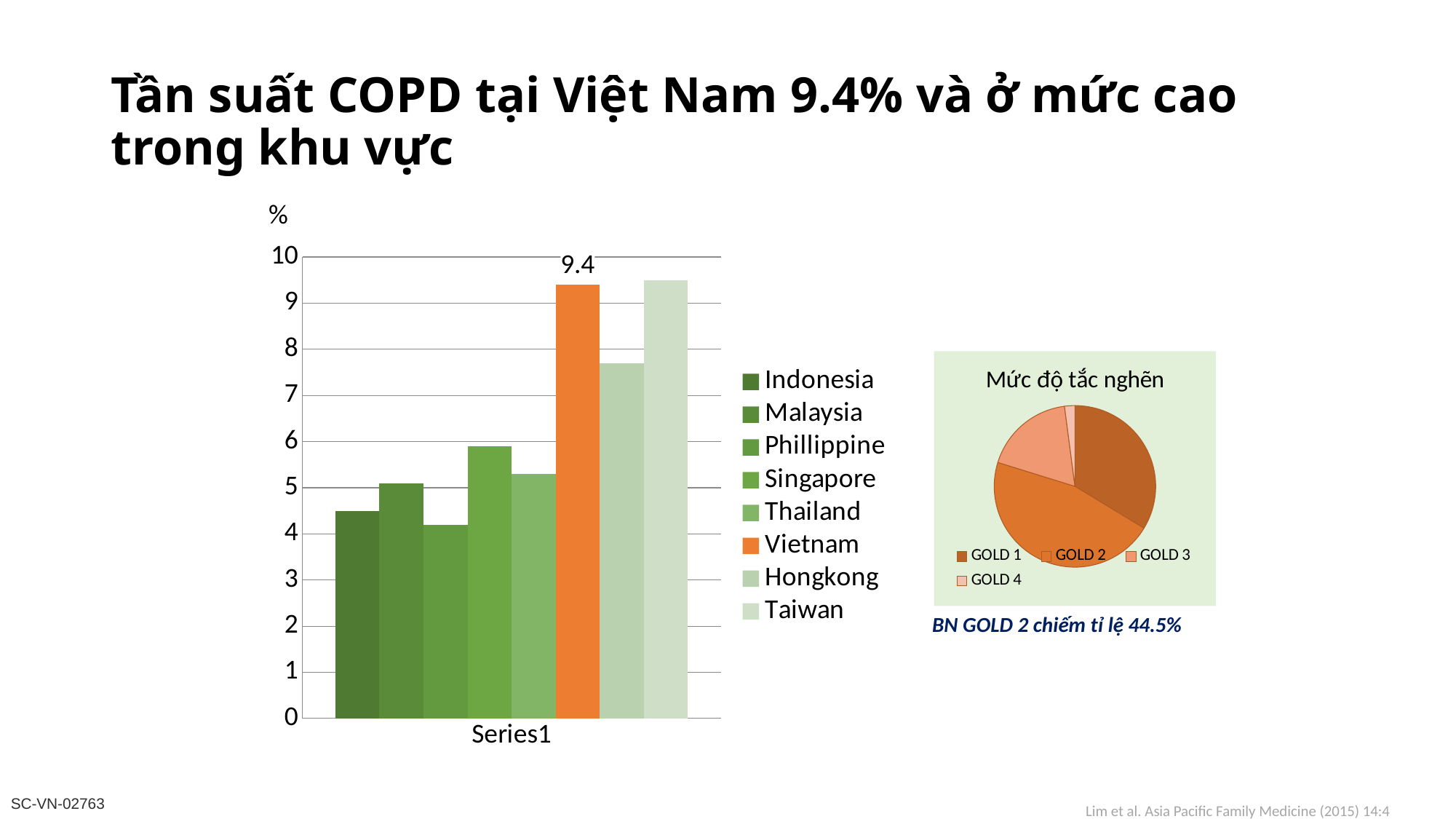
In the bar chart on the left, is the value for Hongkong greater or less than 7? greater In the pie chart titled "Mức độ tắc nghẽn", which slice is the smallest? GOLD 4 In the bar chart on the left, is the value for Phillippine greater or less than 5? less In the pie chart titled "Mức độ tắc nghẽn", what share does GOLD 2 account for? 44.5% How many entries does the legend of the bar chart on the left list? 8 How many entries does the legend of the pie chart titled "Mức độ tắc nghẽn" list? 4 In the bar chart on the left, which is larger, the value for Singapore or the value for Indonesia? Singapore In the bar chart on the left, which is larger, the value for Vietnam or the value for Hongkong? Vietnam What kind of chart is the chart on the left of the slide? bar chart What kind of chart is the chart titled "Mức độ tắc nghẽn"? pie chart In the bar chart on the left, what is the value for Vietnam? 9.4 In the bar chart on the left, is the value for Singapore greater or less than 5? greater